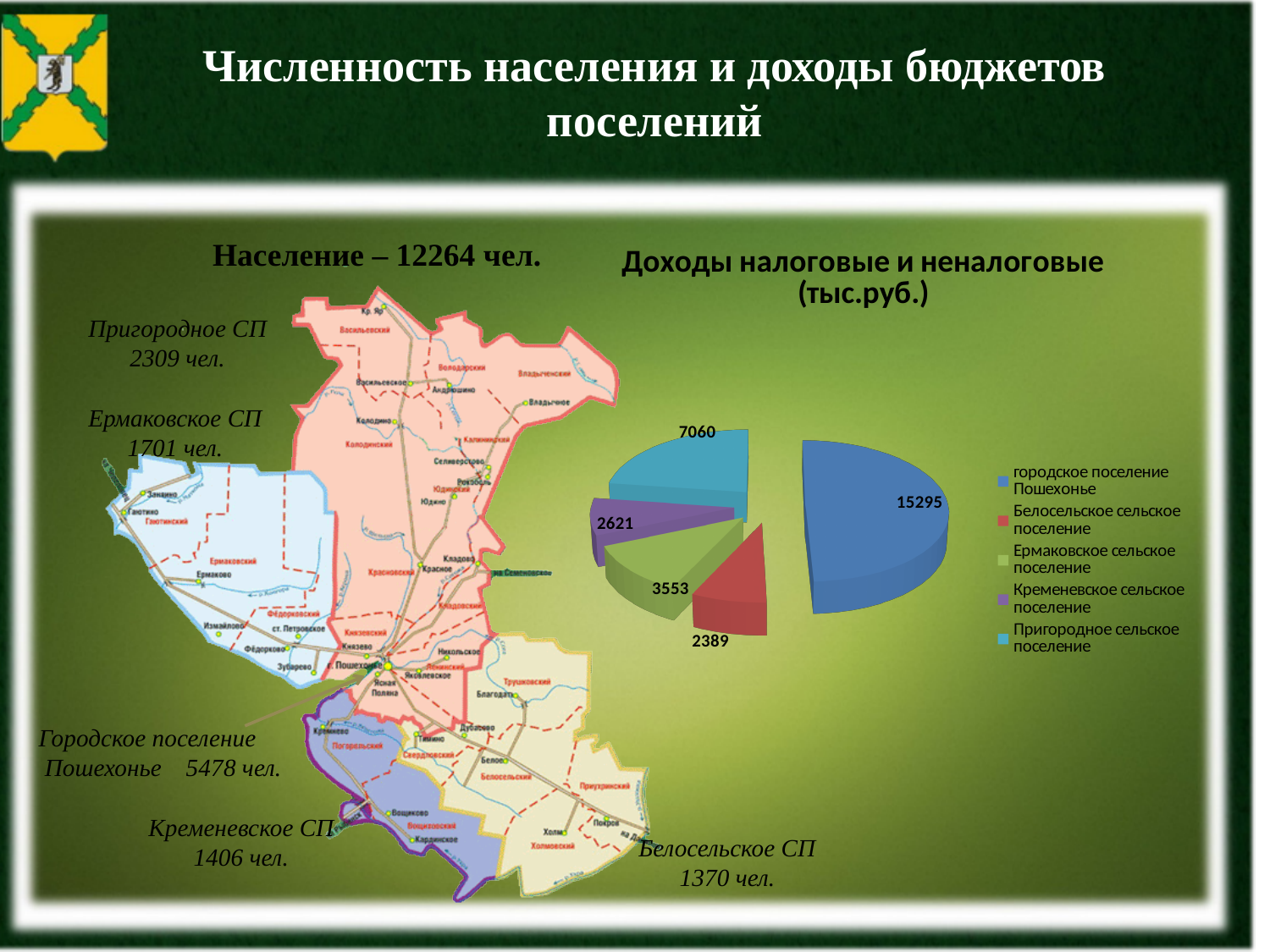
What is the value for Пригородное сельское поселение in the pie chart? 7060 What is the difference between the values for Ермаковское сельское поселение and Кременевское сельское поселение? 932 What is the total of all values shown in the pie chart? 30918 Which settlement has the smallest slice in the pie chart? Белосельское сельское поселение What is the chart's title? Доходы налоговые и неналоговые (тыс.руб.) What is the value for Кременевское сельское поселение in the pie chart? 2621 What type of chart is shown on the slide? pie chart Which is larger: the value for Пригородное сельское поселение or Ермаковское сельское поселение? Пригородное сельское поселение Which settlement has the largest slice in the pie chart? городское поселение Пошехонье How many slices does the pie chart have? 5 What is the value for Белосельское сельское поселение in the pie chart? 2389 What is the value for городское поселение Пошехонье in the pie chart? 15295